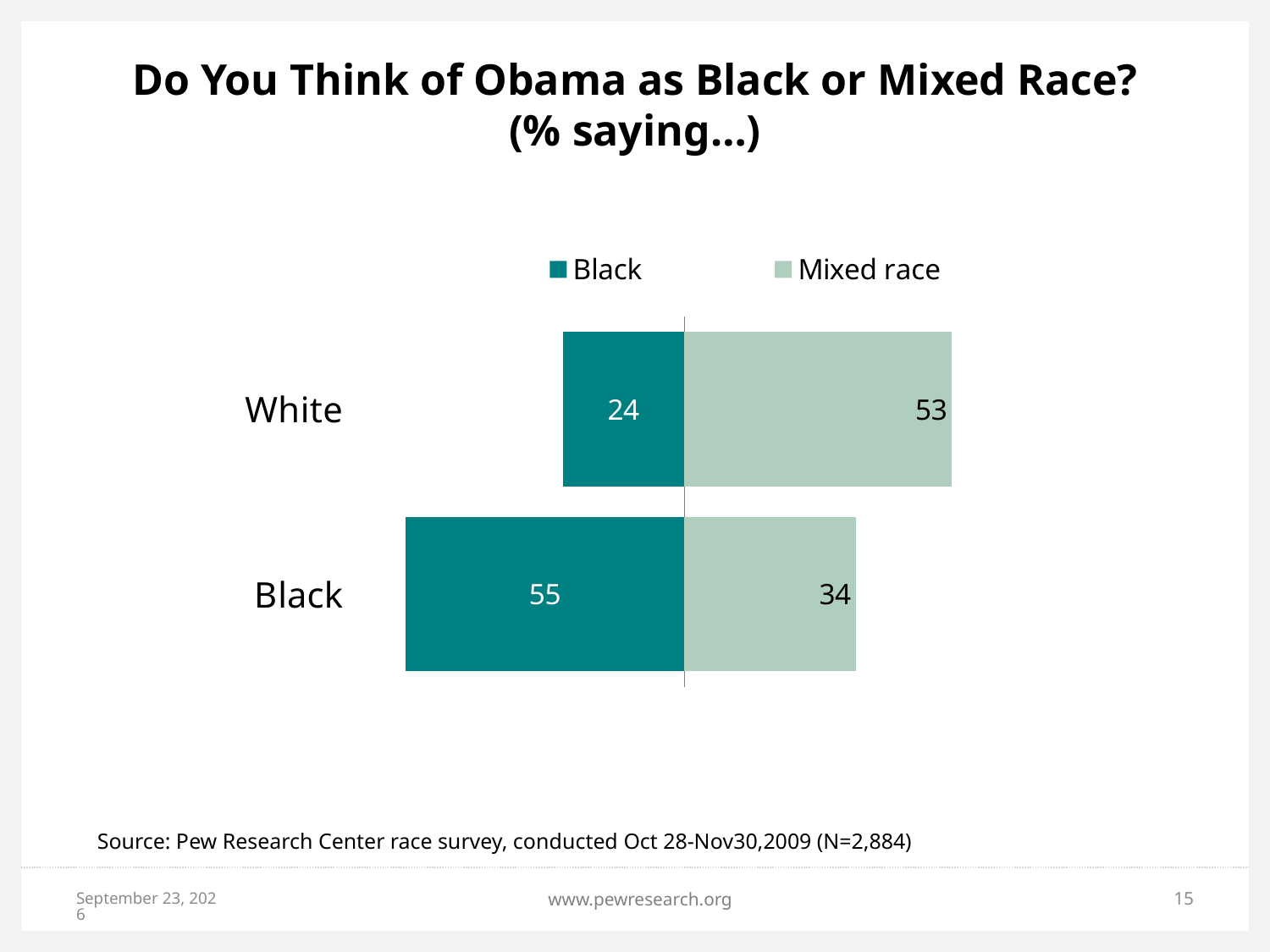
What percentage of Black respondents say they think of Obama as Mixed race? 34 Which respondent group has the lower value for 'Mixed race'? Black What kind of chart is shown on the slide? Bar chart Which respondent group has the higher value for 'Black'? Black What percentage of Black respondents say they think of Obama as Black? 55 What percentage of White respondents say they think of Obama as Black? 24 What is the difference between the 'Black' values for Black and White respondents? 31 How many respondent groups are shown on the chart? 2 Among White respondents, is the value for 'Black' or 'Mixed race' larger? Mixed race What percentage of White respondents say they think of Obama as Mixed race? 53 How many series does the legend list? 2 What is the difference between the 'Mixed race' values for White and Black respondents? 19